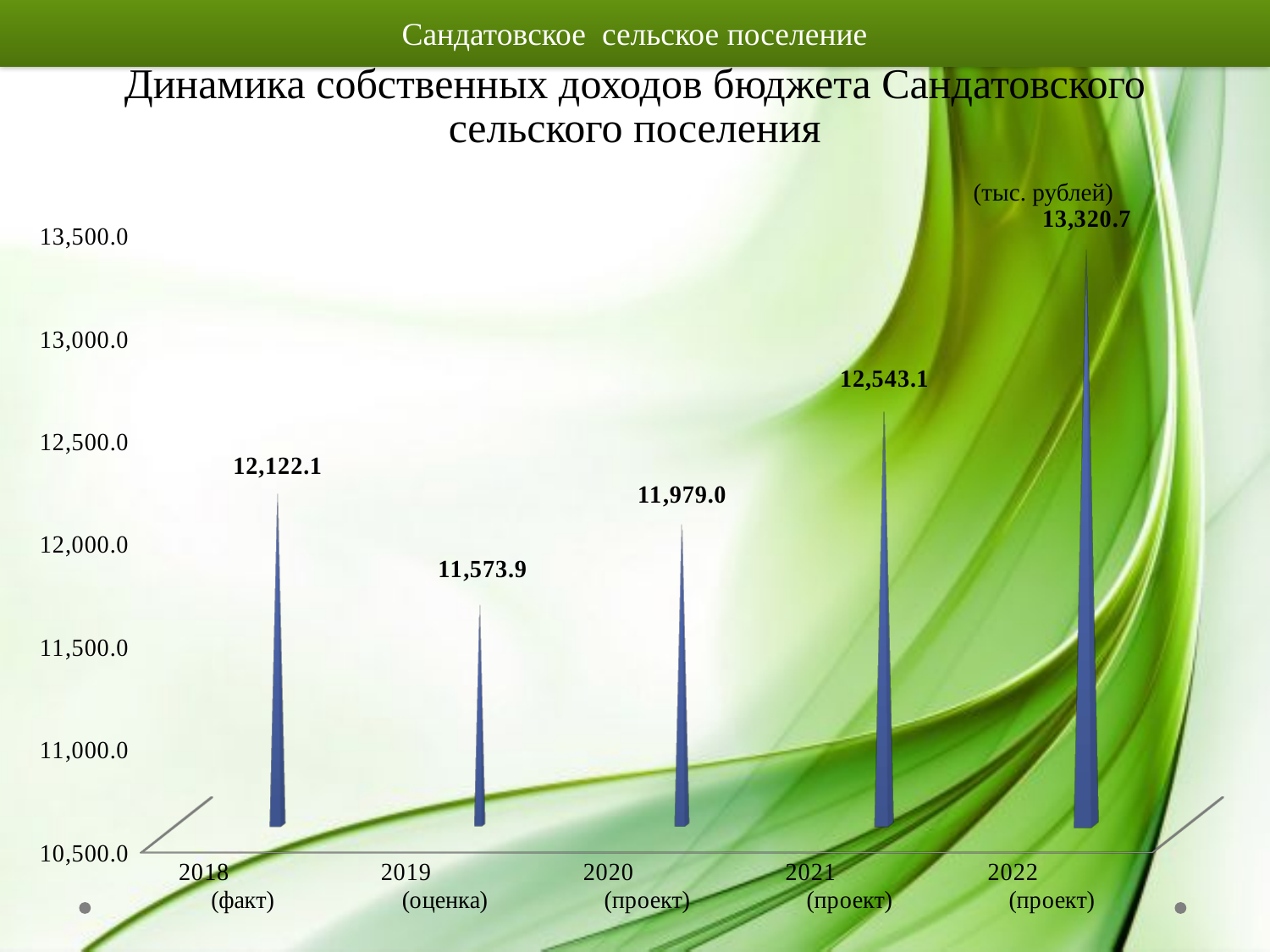
What is the value for 2021 (проект)? 12,543.1 What is the value for 2022 (проект)? 13,320.7 What is the value for 2018 (факт)? 12,122.1 How many years are shown on the x axis? 5 What unit is stated for the values on the chart? тыс. рублей Which year has the highest value? 2022 (проект) Do the values rise or fall from 2019 to 2022? rise Which year has the lowest value? 2019 (оценка) What is the value for 2019 (оценка)? 11,573.9 What is the difference between the values for 2022 and 2021? 777.6 Which is larger, the value for 2018 or the value for 2020? 2018 What is the value for 2020 (проект)? 11,979.0